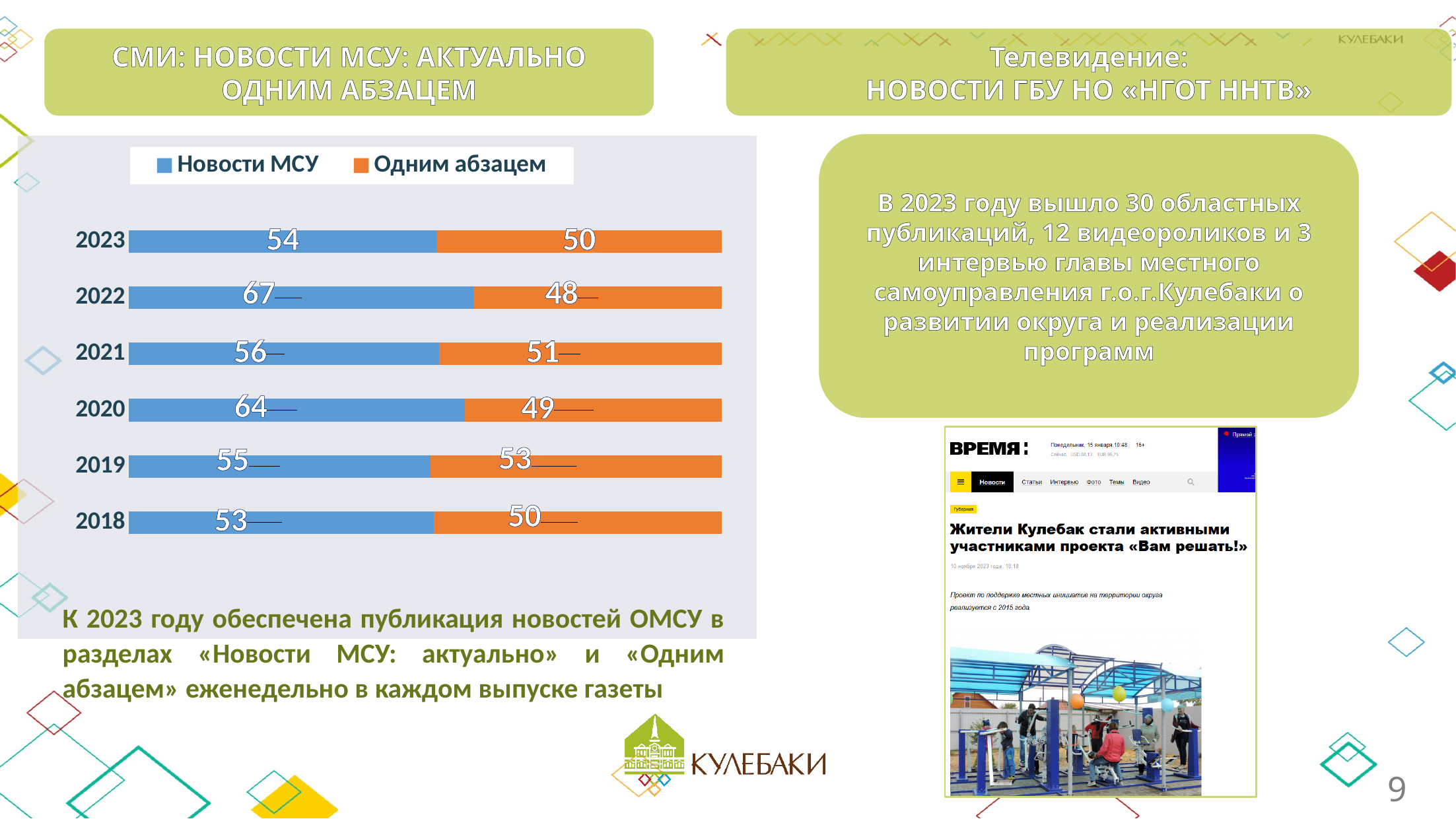
Which colour represents «Одним абзацем» in the chart? Orange In which year is the value for «Новости МСУ» the highest? 2022 How many years are shown on the chart? 6 How many series does the legend list? 2 In which year is the value for «Одним абзацем» the lowest? 2022 What is the difference between the «Новости МСУ» values for 2022 and 2018? 14 What is the total of the stacked bar for 2022? 115 What kind of chart is shown on the slide? Stacked bar chart What is the value for «Новости МСУ» in 2023? 54 Which is larger in 2020: the value for «Новости МСУ» or for «Одним абзацем»? Новости МСУ What is the value for «Одним абзацем» in 2022? 48 What is the value for «Одним абзацем» in 2019? 53